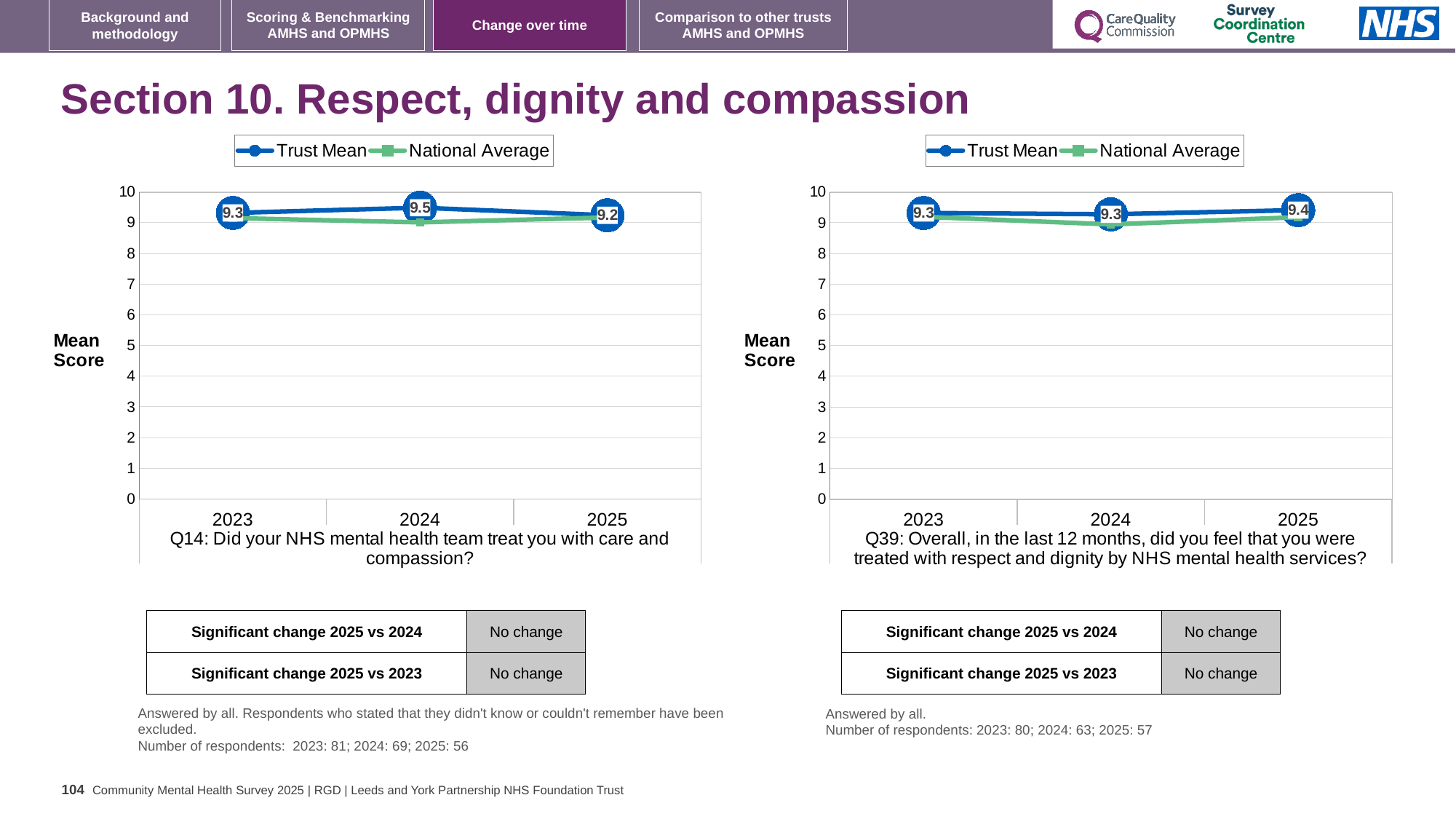
On the Q14 chart (left), what is the difference between the Trust Mean in 2024 and in 2025? 0.3 On the Q39 chart (right), how many years are plotted on the x axis? 3 On the Q39 chart (right), what is the Trust Mean for 2025? 9.4 On the Q14 chart (left), what is the Trust Mean for 2024? 9.5 On the Q14 chart (left), what is the label of the y axis? Mean Score On the Q14 chart (left), which year has the highest Trust Mean? 2024 What type of chart is the Q39 chart (right)? Line chart On the Q14 chart (left), which year has the lowest Trust Mean? 2025 On the Q14 chart (left), how many series does the legend list? 2 On the Q39 chart (right), what is the Trust Mean for 2023? 9.3 On the Q14 chart (left), what is the Trust Mean for 2025? 9.2 On the Q39 chart (right), is the Trust Mean for 2025 greater or less than 9? greater